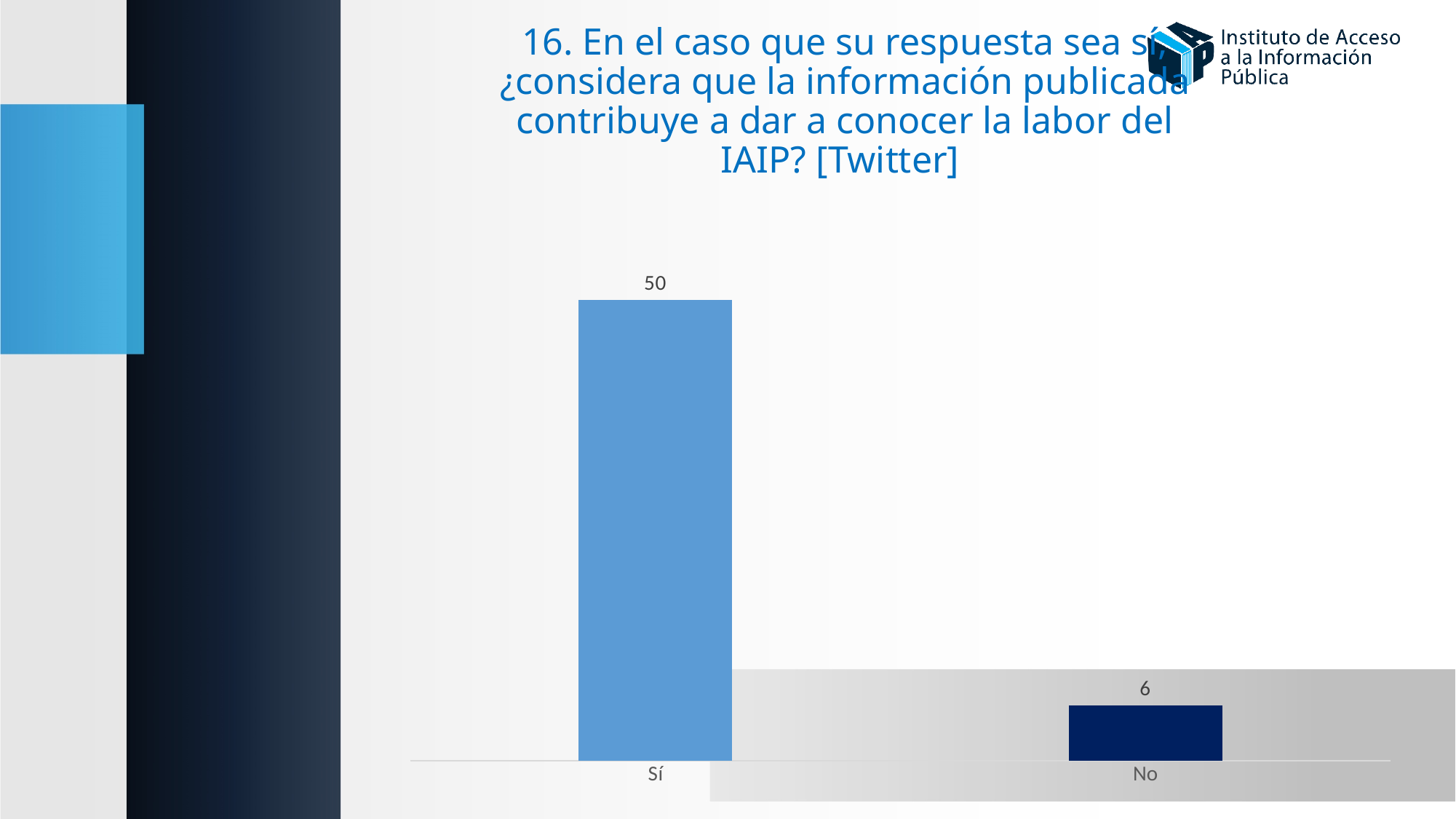
What is the total of the values for Sí and No? 56 What is the value for No? 6 What kind of chart is shown on the slide? Bar chart What colour is the bar for No? Dark navy blue How many categories are shown in the chart? 2 What is the difference between the values for Sí and No? 44 What is the value for Sí? 50 Which category has the highest value? Sí Which category has the lowest value? No Which is larger, the value for Sí or the value for No? Sí Which platform is named in brackets in the chart title? Twitter